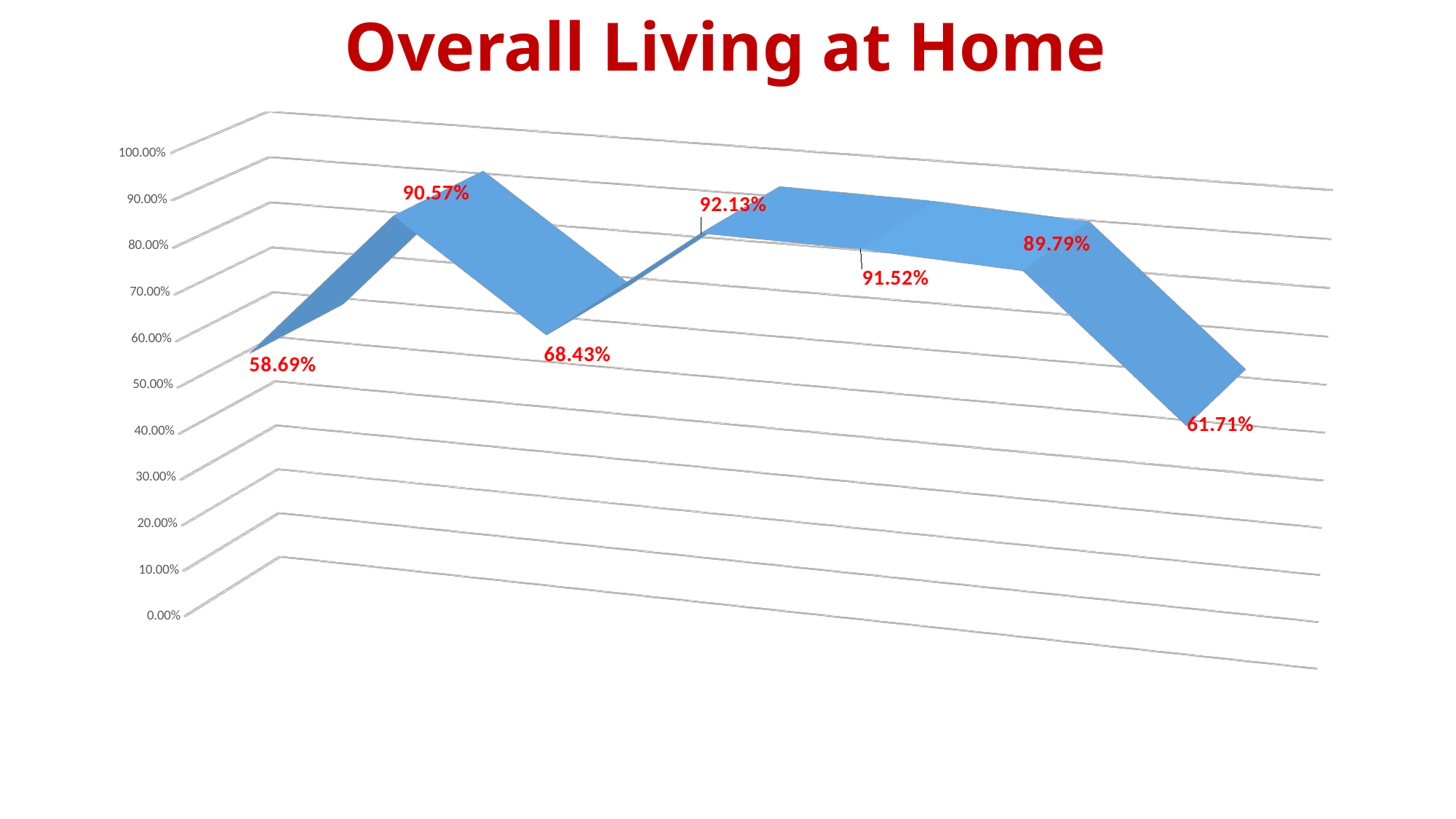
What is the title of the chart? Overall Living at Home Do the values rise or fall from the sixth data point to the seventh data point? fall What is the highest value shown on the chart? 92.13% What is the lowest value shown on the chart? 58.69% What is the value of the first data point on the chart? 58.69% What kind of chart is shown on the slide? 3D line chart What is the difference between the second data point (90.57%) and the first data point (58.69%)? 31.88% How many data points are plotted on the chart? 7 Which is larger, the fourth data point or the fifth data point? The fourth data point (92.13%) What is the value of the last data point on the chart? 61.71% What is the value of the third data point on the chart? 68.43% Is the value of the third data point greater or less than 60.00%? greater